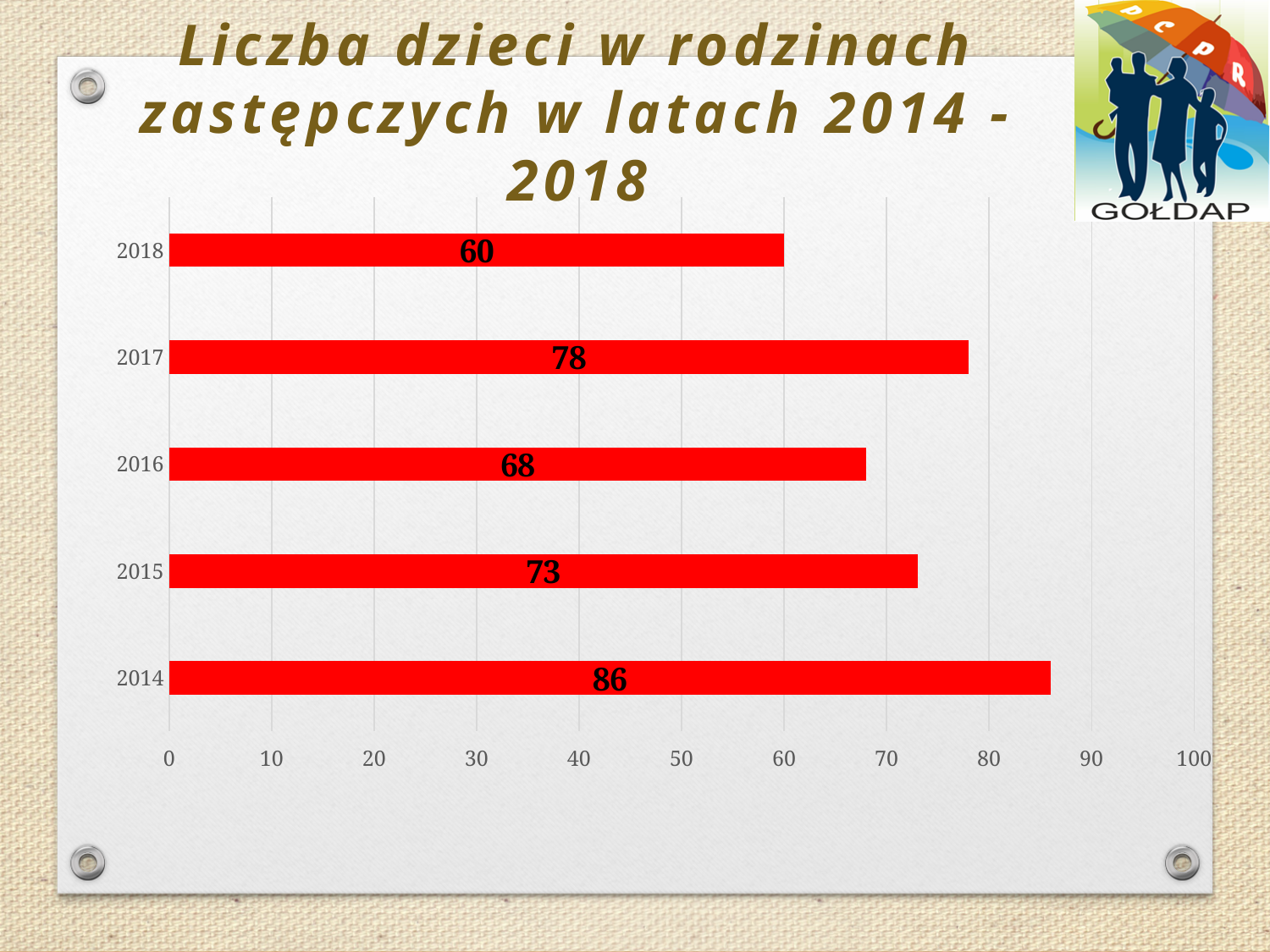
Which year has the highest value? 2014 What is the title of the chart? Liczba dzieci w rodzinach zastępczych w latach 2014 - 2018 Which year has the lowest value? 2018 What is the value for 2018? 60 What kind of chart is shown on the slide? bar chart What is the value for 2016? 68 What is the difference between the values for 2017 and 2016? 10 Which is larger, the value for 2015 or the value for 2016? 2015 Is the value for 2017 greater or less than 70? greater What is the difference between the values for 2014 and 2018? 26 How many years are shown on the chart? 5 What is the value for 2014? 86